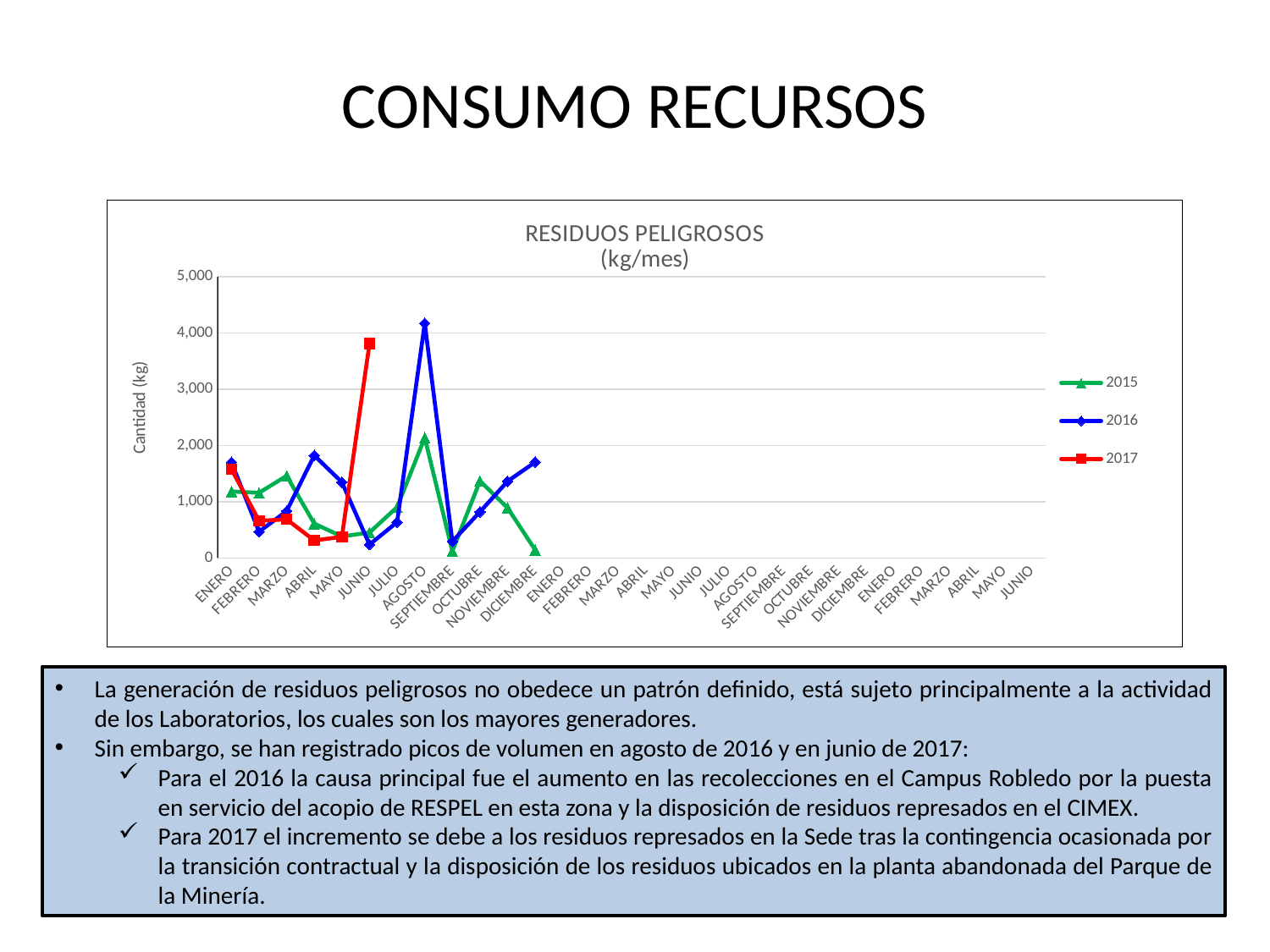
In which month does the 2017 series reach its highest value? JUNIO Which series reaches the highest value on the chart? 2016 In which month does the 2016 series reach its highest value? AGOSTO How many series does the legend list? 3 How many data points does the 2017 series have? 6 Is the value for 2015 in SEPTIEMBRE greater or less than 1,000? less Is the value for 2016 in AGOSTO greater or less than 4,000? greater Which series are listed in the legend? 2015, 2016, 2017 What is the title of the chart? RESIDUOS PELIGROSOS (kg/mes) Which is larger, the 2015 value in MARZO or the 2016 value in MARZO? 2015 Is the value for 2017 in JUNIO greater or less than 4,000? less What kind of chart is shown on the slide? line chart